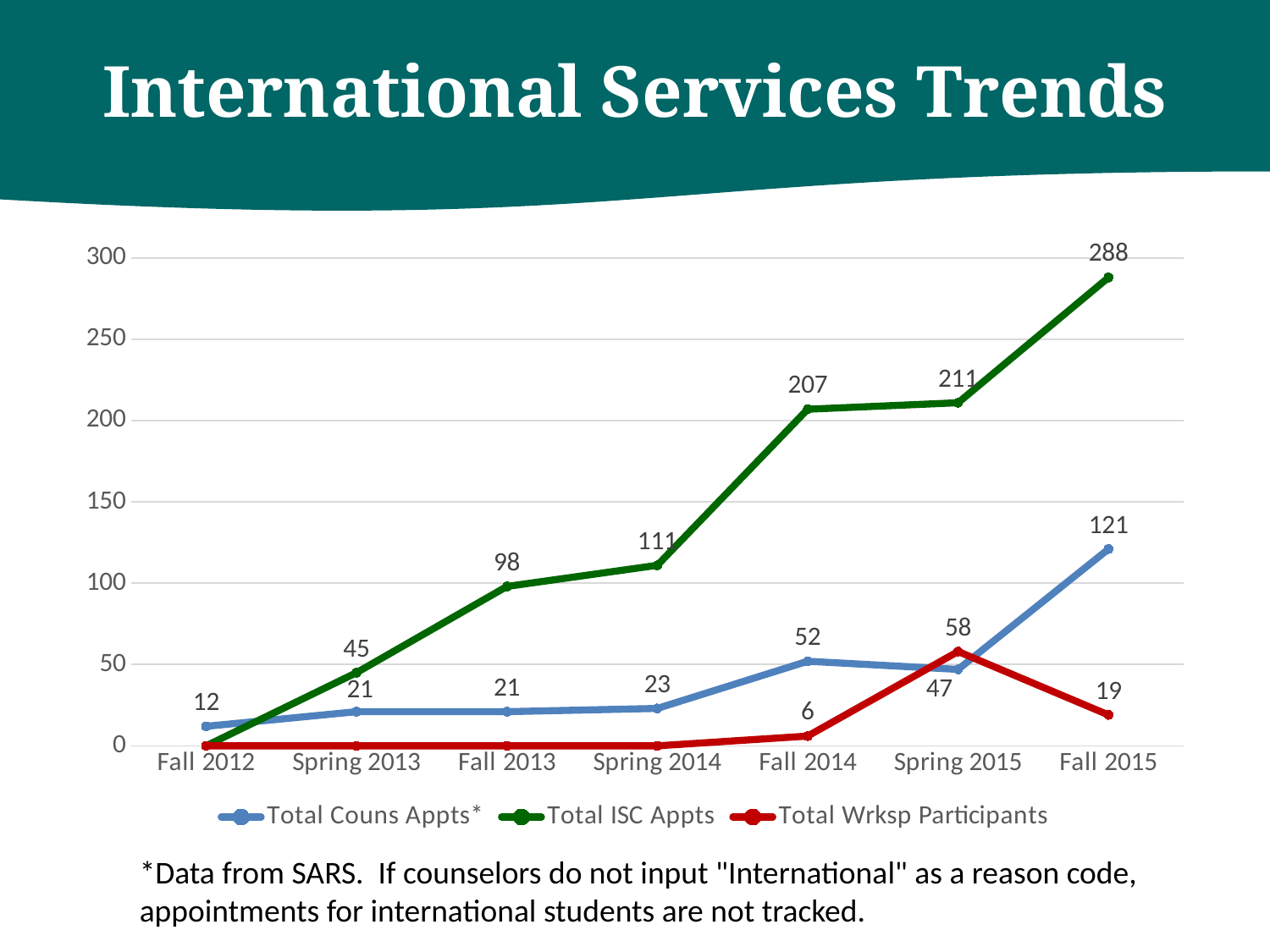
In Spring 2015, which is larger: Total Couns Appts* or Total Wrksp Participants? Total Wrksp Participants What is the difference between Total ISC Appts in Fall 2015 and Spring 2015? 77 What is the value of Total Couns Appts* in Fall 2014? 52 How many series does the legend list? 3 What is the value of Total ISC Appts in Fall 2015? 288 How many terms are shown on the x axis? 7 What kind of chart is shown on the slide? Line chart What is the value of Total Wrksp Participants in Spring 2015? 58 Is the value for Total ISC Appts in Fall 2014 greater or less than 150? greater In which term is Total Couns Appts* lowest? Fall 2012 What is the difference between Total Couns Appts* in Fall 2015 and Spring 2015? 74 In which term is Total ISC Appts highest? Fall 2015